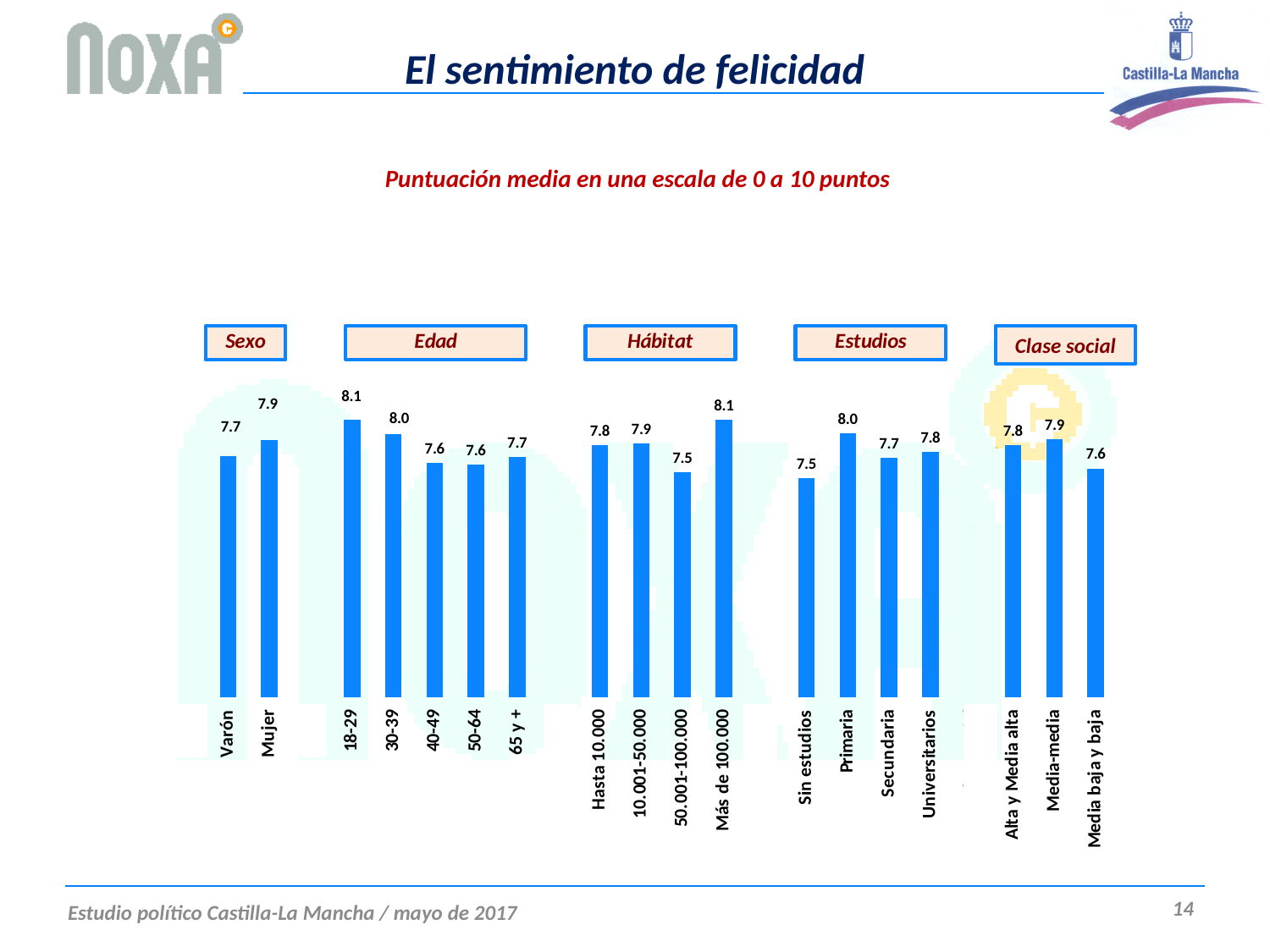
In the Edad chart, which age group has the highest value? 18-29 In the Estudios chart, what is the difference between Primaria and Sin estudios? 0.5 In the Clase social chart, which is larger, Media-media or Media baja y baja? Media-media In the Hábitat chart, what is the value for Más de 100.000? 8.1 How many categories are shown in the Hábitat chart? 4 What kind of chart is used in the Edad section? Bar chart What is the subtitle shown above the charts describing the scale? Puntuación media en una escala de 0 a 10 puntos In the Sexo chart, what is the difference between Mujer and Varón? 0.2 In the Estudios chart, what is the value for Universitarios? 7.8 In the Hábitat chart, which category has the lowest value? 50.001-100.000 How many categories are shown in the Edad chart? 5 In the Sexo chart, what is the value for Mujer? 7.9